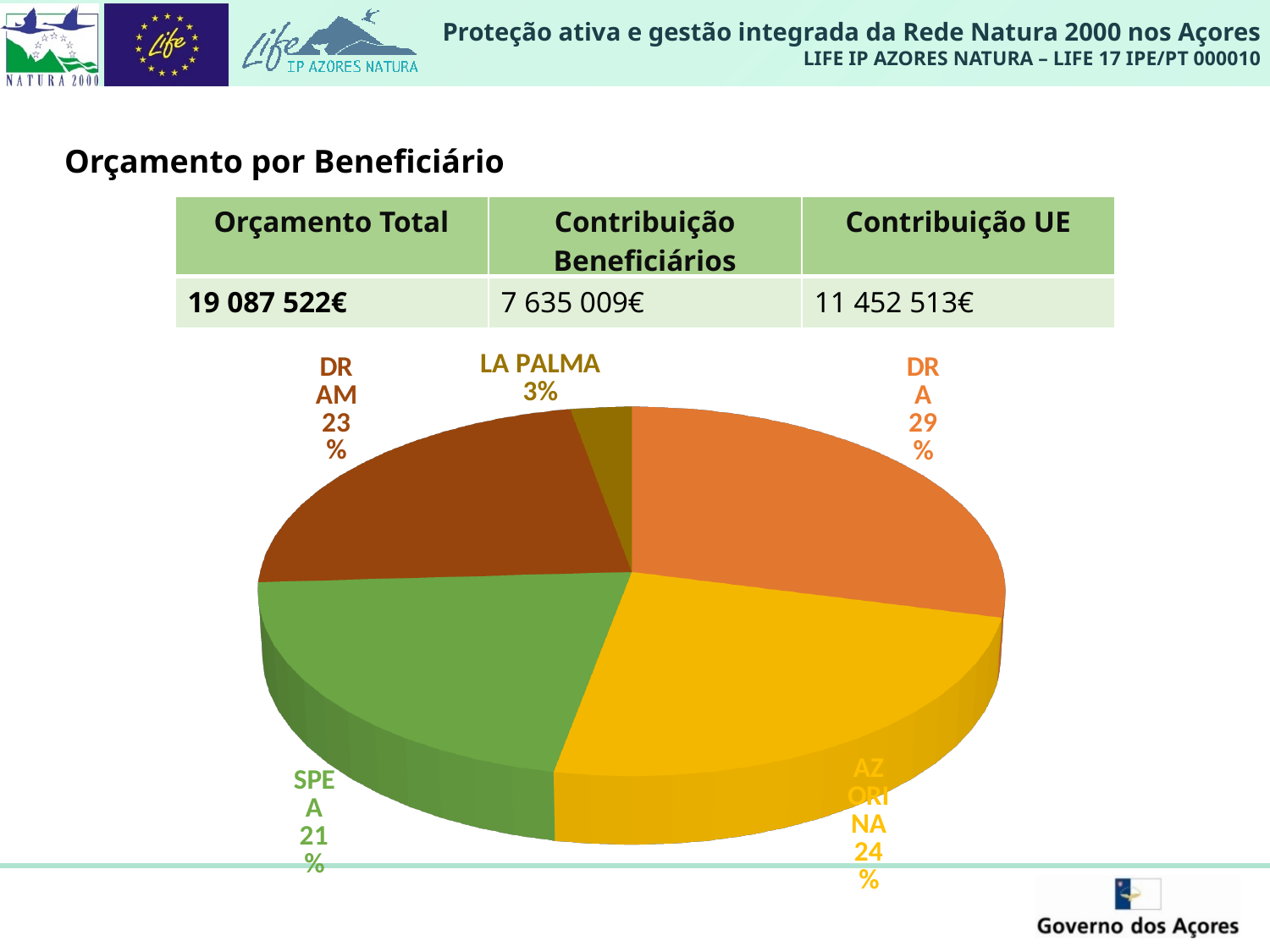
What share of the pie does LA PALMA hold? 3% What share of the pie does DRAM hold? 23% What colour is the AZORINA slice of the pie? yellow What share of the pie does SPEA hold? 21% How many slices does the pie chart have? 5 What share of the pie does AZORINA hold? 24% What is the difference in percentage points between the DRA slice and the SPEA slice? 8 Which slice is larger, DRAM or LA PALMA? DRAM What kind of chart is shown on the slide? pie chart What share of the pie does DRA hold? 29% Which beneficiary has the smallest slice of the pie? LA PALMA Which beneficiary has the largest slice of the pie? DRA